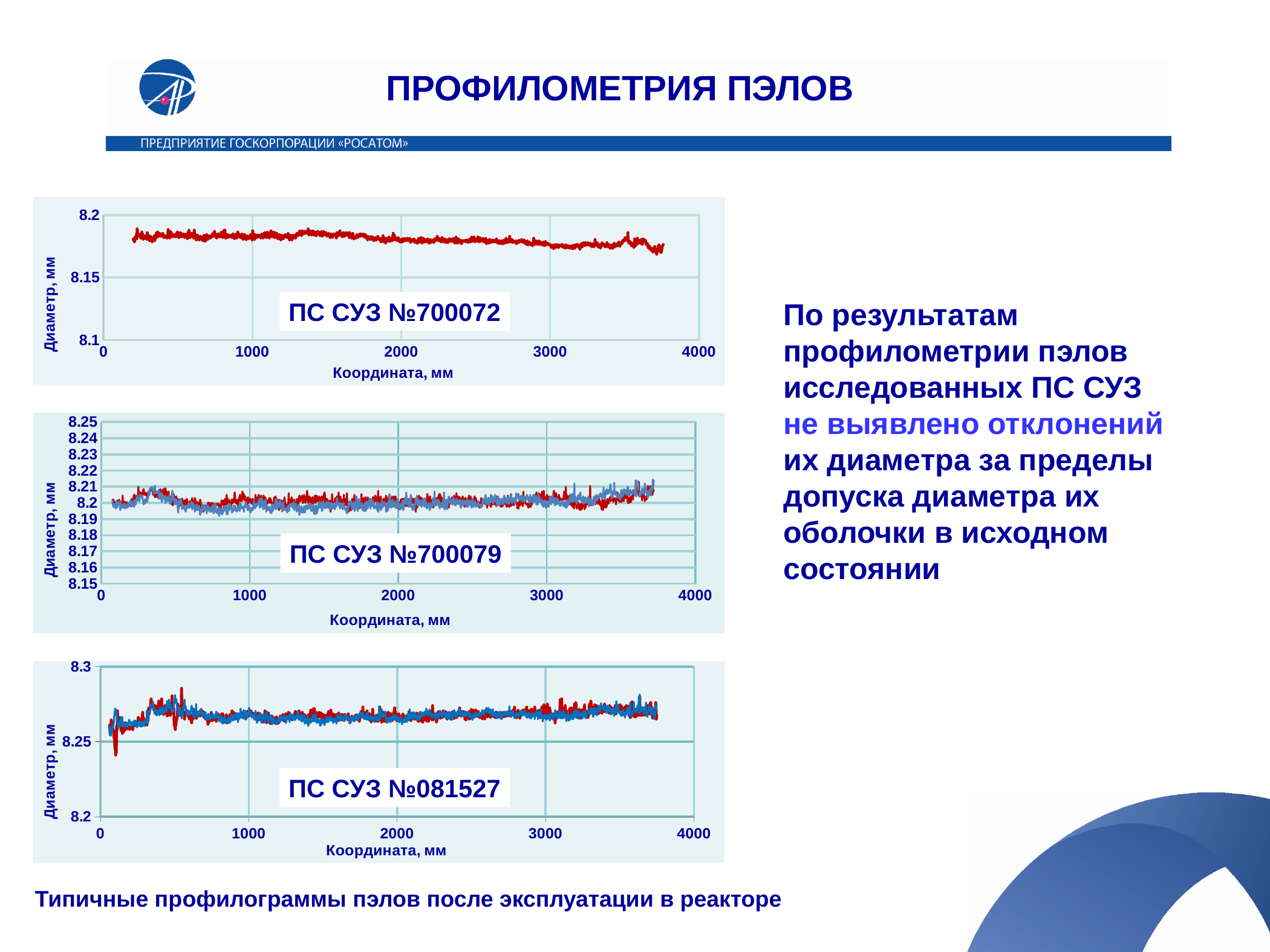
What is the y-axis label of the top chart (ПС СУЗ №700072)? Диаметр, мм What is the x-axis label of the middle chart (ПС СУЗ №700079)? Координата, мм In the top chart (ПС СУЗ №700072), does the diameter generally rise or fall as the coordinate increases from 1000 mm to 3000 mm? fall In the bottom chart (ПС СУЗ №081527), is the diameter value at coordinate 2000 mm greater or less than 8.25? greater In the middle chart (ПС СУЗ №700079), is the diameter value at coordinate 2000 mm greater or less than 8.25? less In the middle chart (ПС СУЗ №700079), is the diameter value at coordinate 2000 mm greater or less than 8.15? greater How many charts are shown on the slide? 3 What kind of chart is the top chart, labelled ПС СУЗ №700072? line chart How many lines are plotted in the bottom chart (ПС СУЗ №081527)? 2